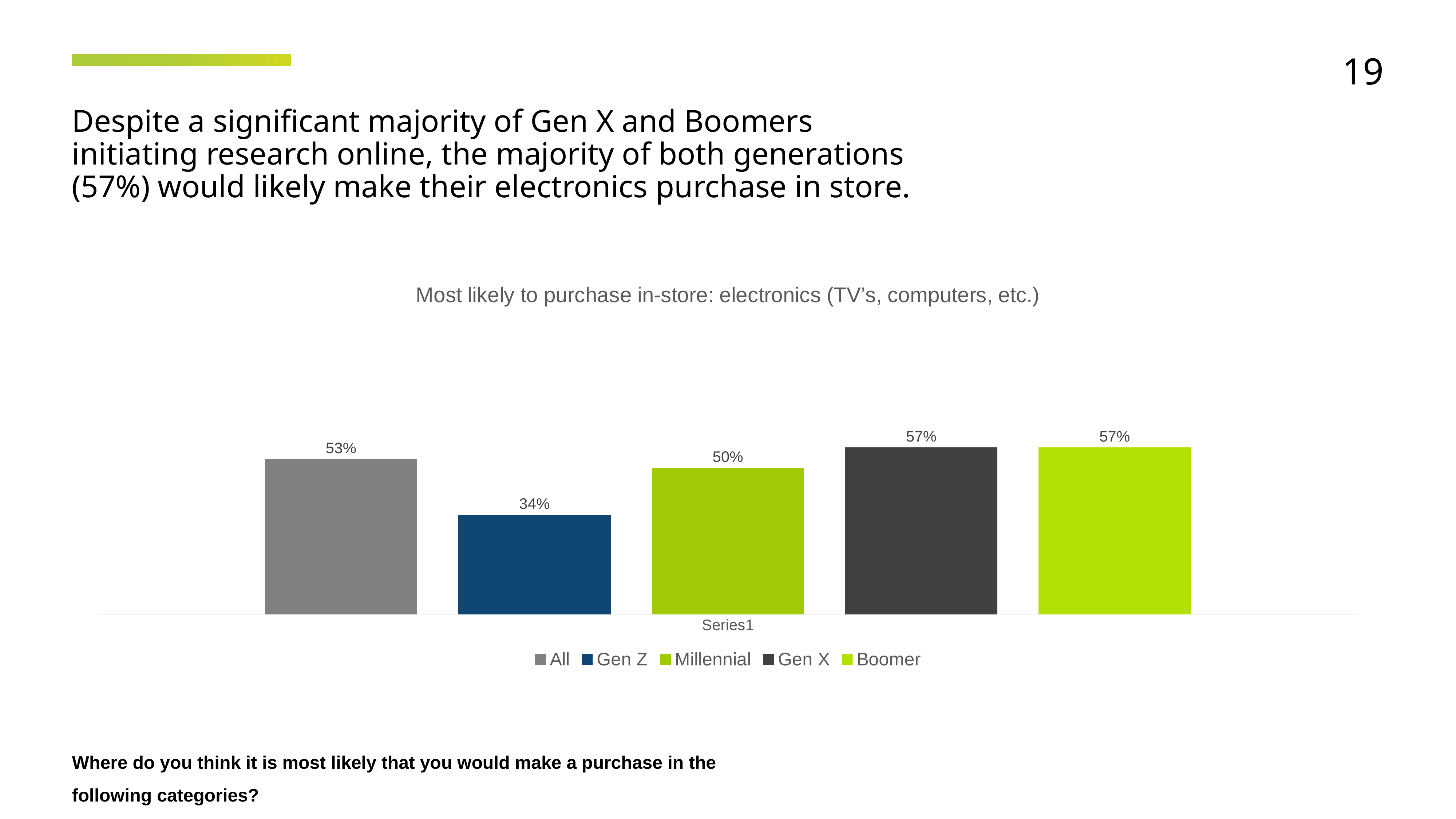
What is the value for Millennial in the chart? 50% What is the highest value shown in the chart? 57% What is the value for All in the chart? 53% Which group has the lowest value in the chart? Gen Z How many series does the legend list? 5 What type of chart is shown on the slide? Bar chart What is the difference between the values for All and Millennial? 3% What is the value for Gen X in the chart? 57% What is the value for Gen Z in the chart? 34% What is the difference between the values for Gen X and Gen Z? 23% Which is larger, the value for Millennial or the value for Gen Z? Millennial What is the value for Boomer in the chart? 57%